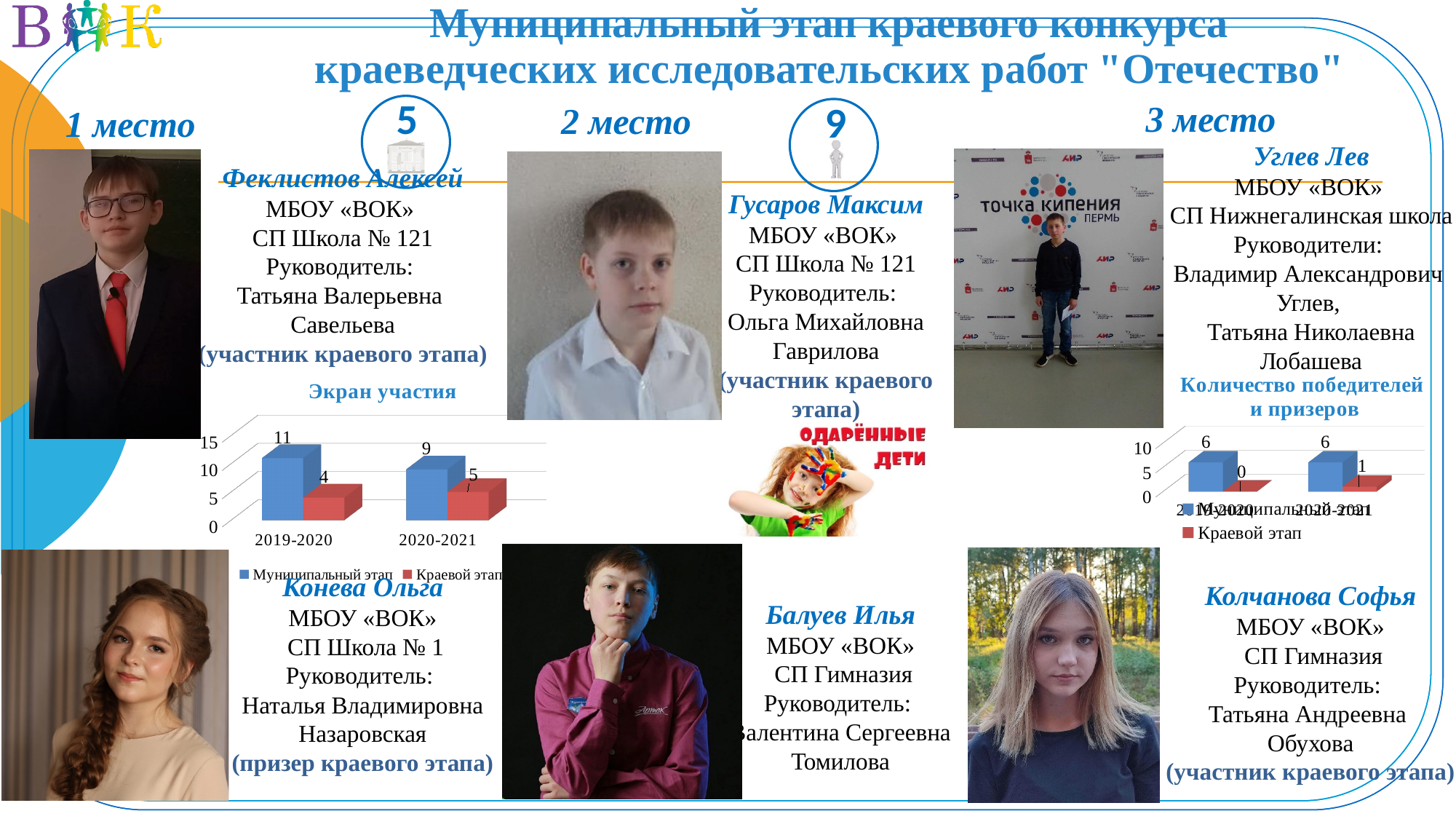
In the chart titled "Экран участия", what is the value for Краевой этап in 2020-2021? 5 What kind of chart is the chart titled "Экран участия"? bar chart In the chart titled "Количество победителей и призеров", which series has the lowest value in 2019-2020? Краевой этап In the chart titled "Количество победителей и призеров", what is the value for Муниципальный этап in 2019-2020? 6 In the chart titled "Количество победителей и призеров", is the Муниципальный этап value for 2020-2021 larger or smaller than the Краевой этап value for 2020-2021? larger In the chart titled "Экран участия", what is the value for Муниципальный этап in 2019-2020? 11 In the chart titled "Количество победителей и призеров", what is the value for Краевой этап in 2020-2021? 1 In the chart titled "Экран участия", did the Муниципальный этап value rise or fall from 2019-2020 to 2020-2021? fall In the chart titled "Экран участия", how many series does the legend list? 2 In the chart titled "Экран участия", which category has the highest Муниципальный этап value? 2019-2020 How many categories are shown on the x axis of the chart titled "Количество победителей и призеров"? 2 In the chart titled "Экран участия", what is the difference between Муниципальный этап and Краевой этап in 2019-2020? 7